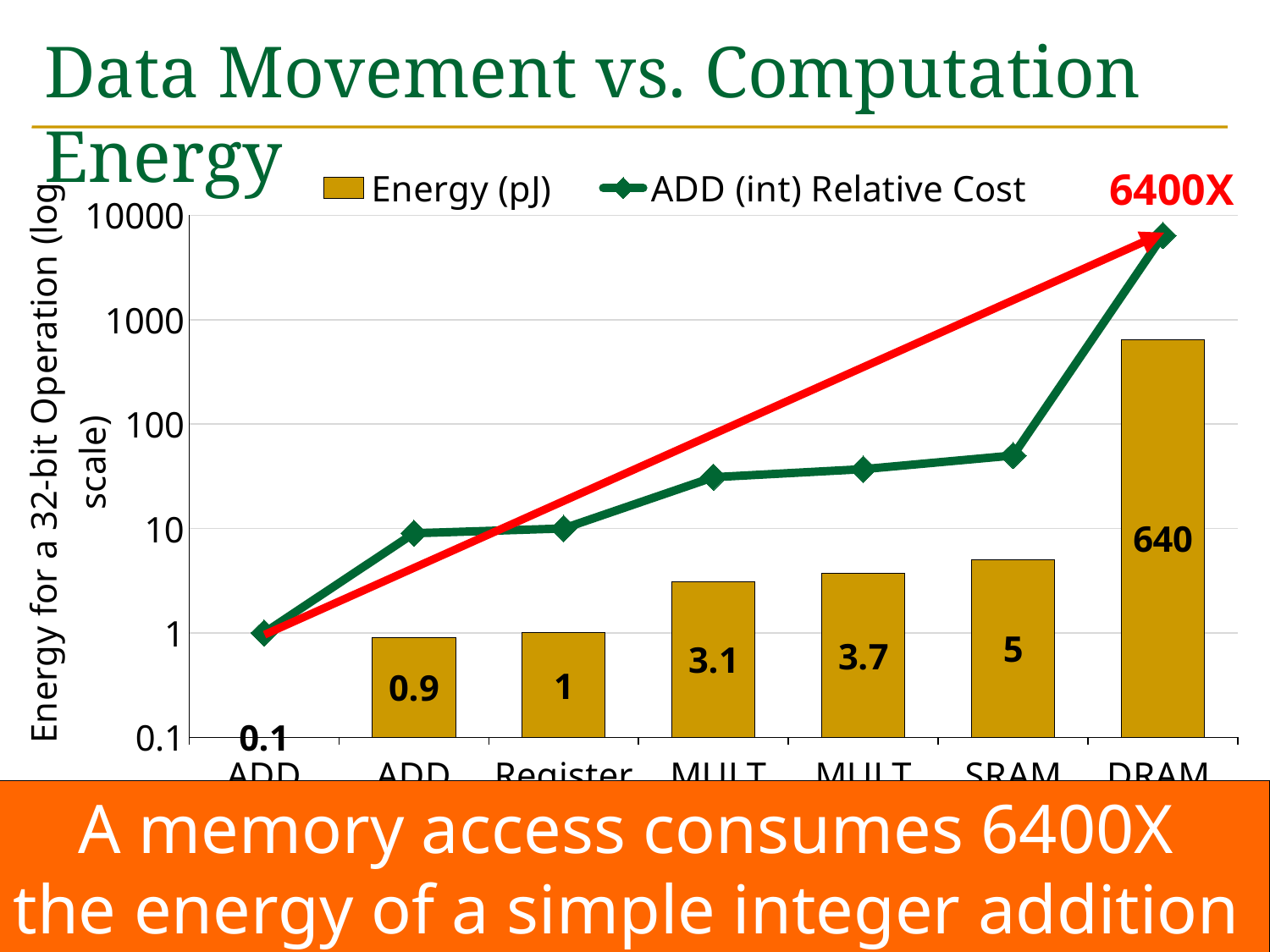
Which has a larger Energy (pJ) value, SRAM or Register? SRAM Is the ADD (int) Relative Cost value at SRAM greater or less than 10? greater What kind of chart is this? Combined bar and line chart What is the Energy (pJ) value shown for Register? 1 How many categories are shown on the x axis? 7 What is the difference between the Energy (pJ) values for DRAM and SRAM? 635 What is the Energy (pJ) value shown for DRAM? 640 Is the ADD (int) Relative Cost value at DRAM greater or less than 1000? greater Which category has the lowest Energy (pJ) value? ADD (the first category, 0.1) How many series does the legend list? 2 What is the Energy (pJ) value shown for SRAM? 5 Which category has the highest Energy (pJ) bar? DRAM